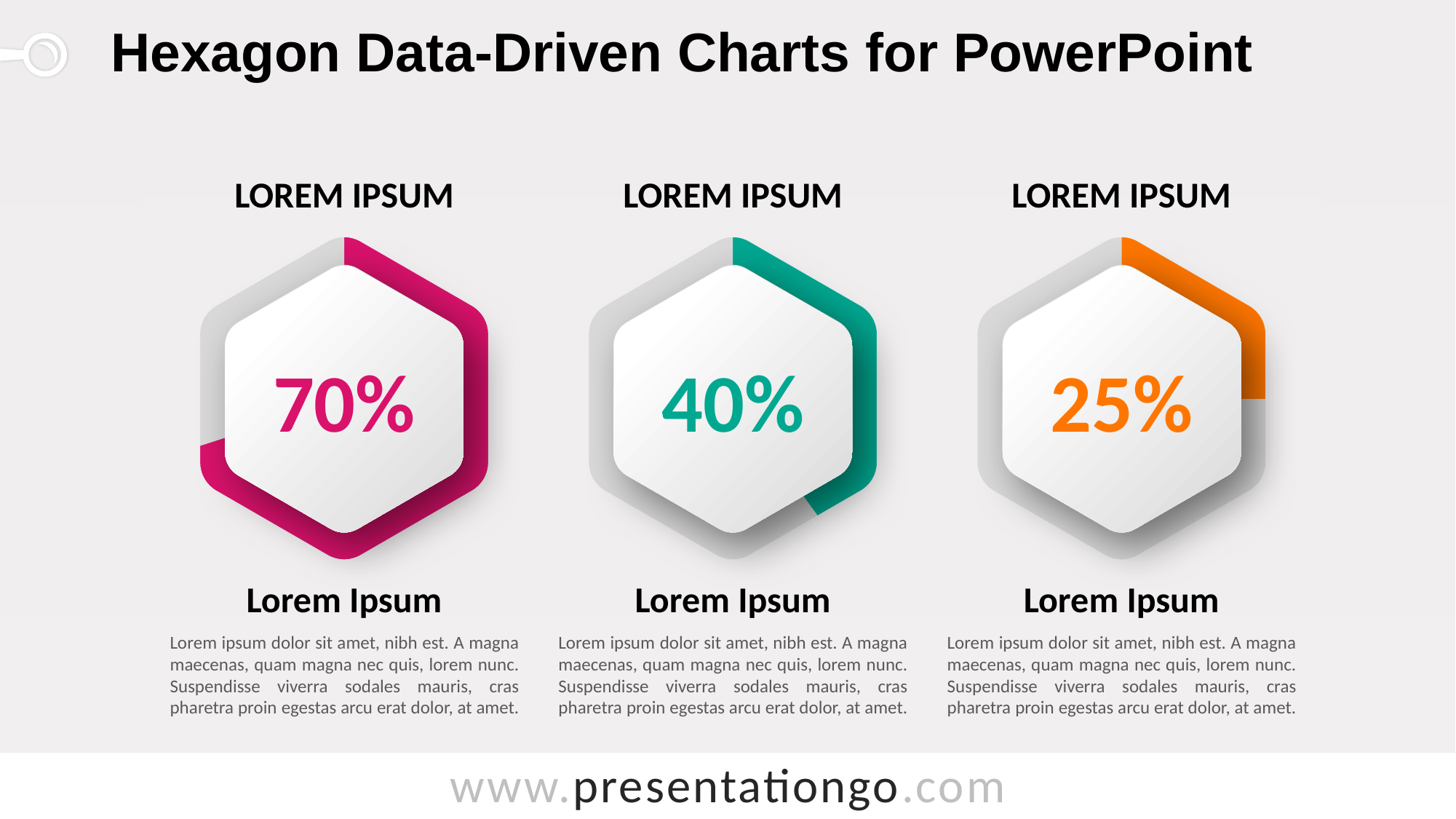
What is the difference between the value in the middle hexagon chart and the value in the right hexagon chart? 15% What is the difference between the value in the left hexagon chart and the value in the middle hexagon chart? 30% What value is shown in the left hexagon chart? 70% What colour is the progress ring of the hexagon chart showing 40%? Teal (green) Which of the three hexagon charts shows the lowest value? The right one (25%) What value is shown in the right hexagon chart? 25% Which of the three hexagon charts shows the highest value? The left one (70%) What value is shown in the middle hexagon chart? 40% How many hexagon charts are shown on the slide? 3 Which is larger, the value in the middle hexagon chart or the value in the right hexagon chart? The middle hexagon chart (40%) Do the values decrease or increase from the left hexagon chart to the right hexagon chart? Decrease What colour is the progress ring of the hexagon chart showing 25%? Orange